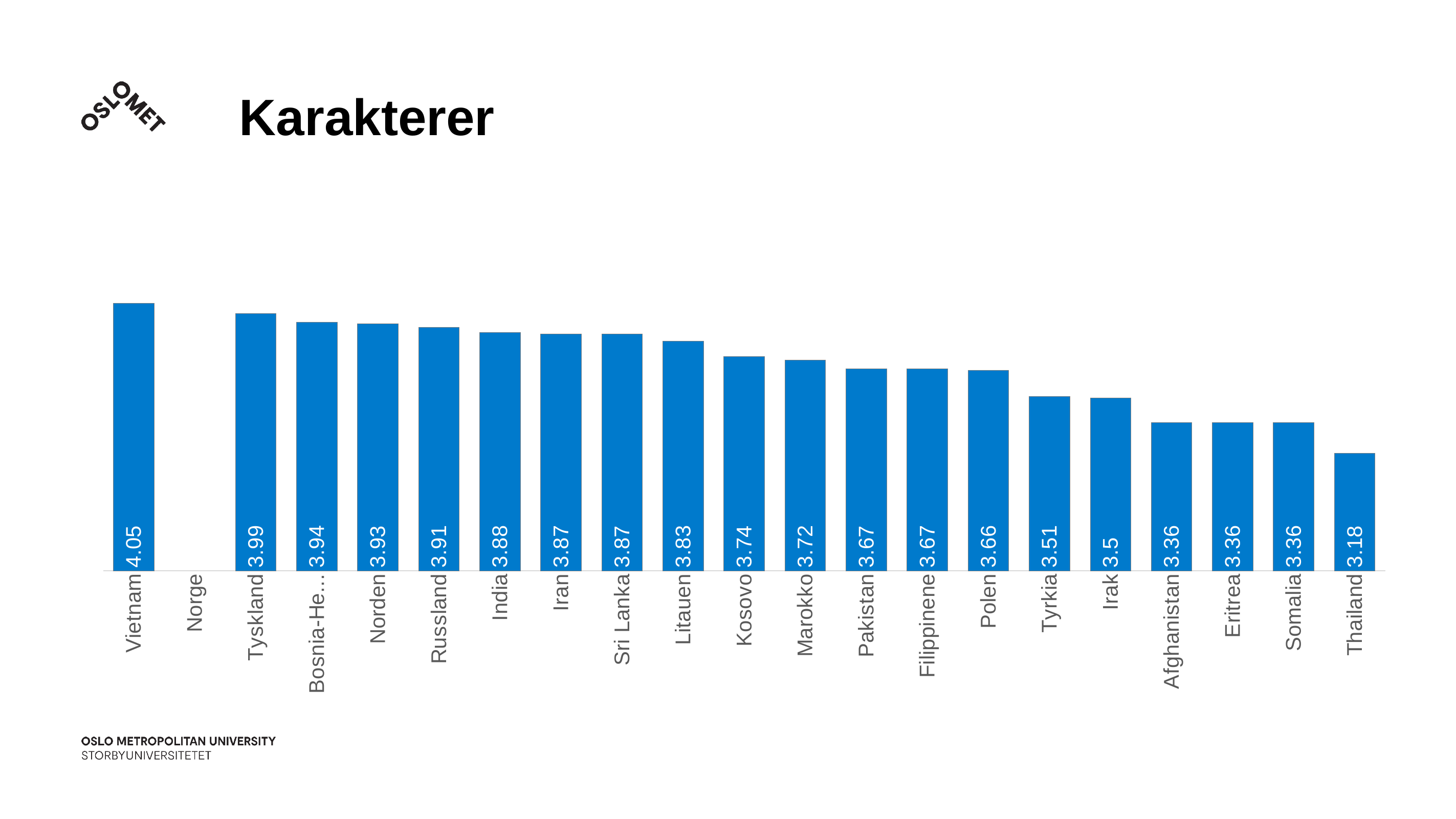
What is the value for Kosovo? 3.74 What is the difference between the values for Tyskland and Polen? 0.33 What is the title of the slide? Karakterer What is the value for Irak? 3.5 What is the value for Thailand? 3.18 Which category has the highest value? Vietnam Which category has the lowest value? Thailand What kind of chart is shown on the slide? Bar chart What is the value for Vietnam? 4.05 What is the difference between the values for Vietnam and Thailand? 0.87 Which is larger, the value for Kosovo or the value for Marokko? Kosovo How many categories are labelled on the x axis? 21